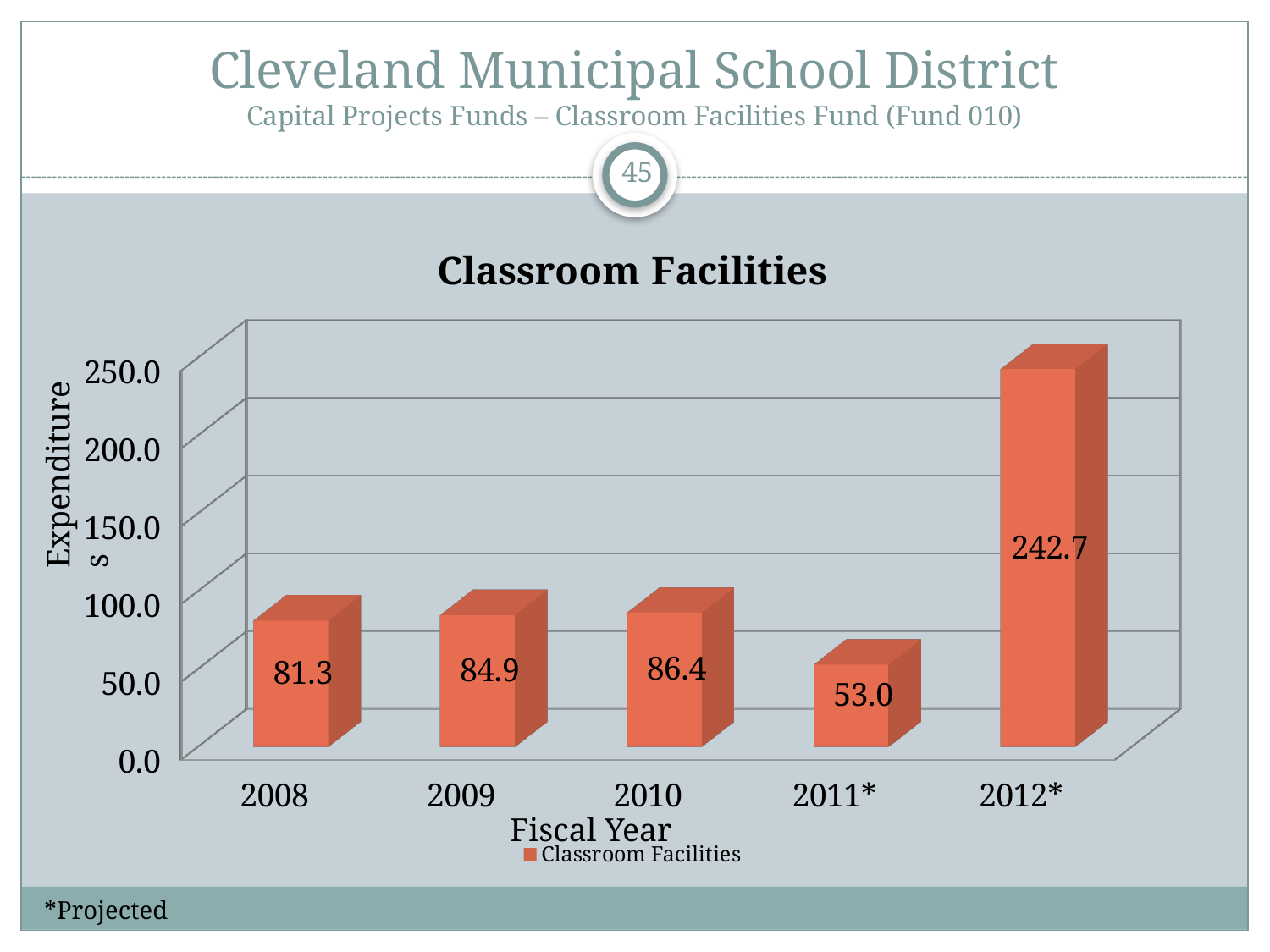
What is the Classroom Facilities expenditure for fiscal year 2008? 81.3 How many fiscal years are shown on the x axis of the Classroom Facilities chart? 5 What is the projected Classroom Facilities expenditure for fiscal year 2012*? 242.7 Which fiscal year has the lowest Classroom Facilities expenditure? 2011* What kind of chart is the Classroom Facilities chart? bar chart Which fiscal year has the highest Classroom Facilities expenditure? 2012* What is the label of the x axis on the Classroom Facilities chart? Fiscal Year What is the difference between the 2012* and 2011* Classroom Facilities expenditures? 189.7 What is the Classroom Facilities expenditure for fiscal year 2010? 86.4 Is the Classroom Facilities expenditure for 2012* greater or less than 200.0? greater Which is larger, the Classroom Facilities expenditure for 2010 or for 2011*? 2010 What is the difference between the 2009 and 2008 Classroom Facilities expenditures? 3.6